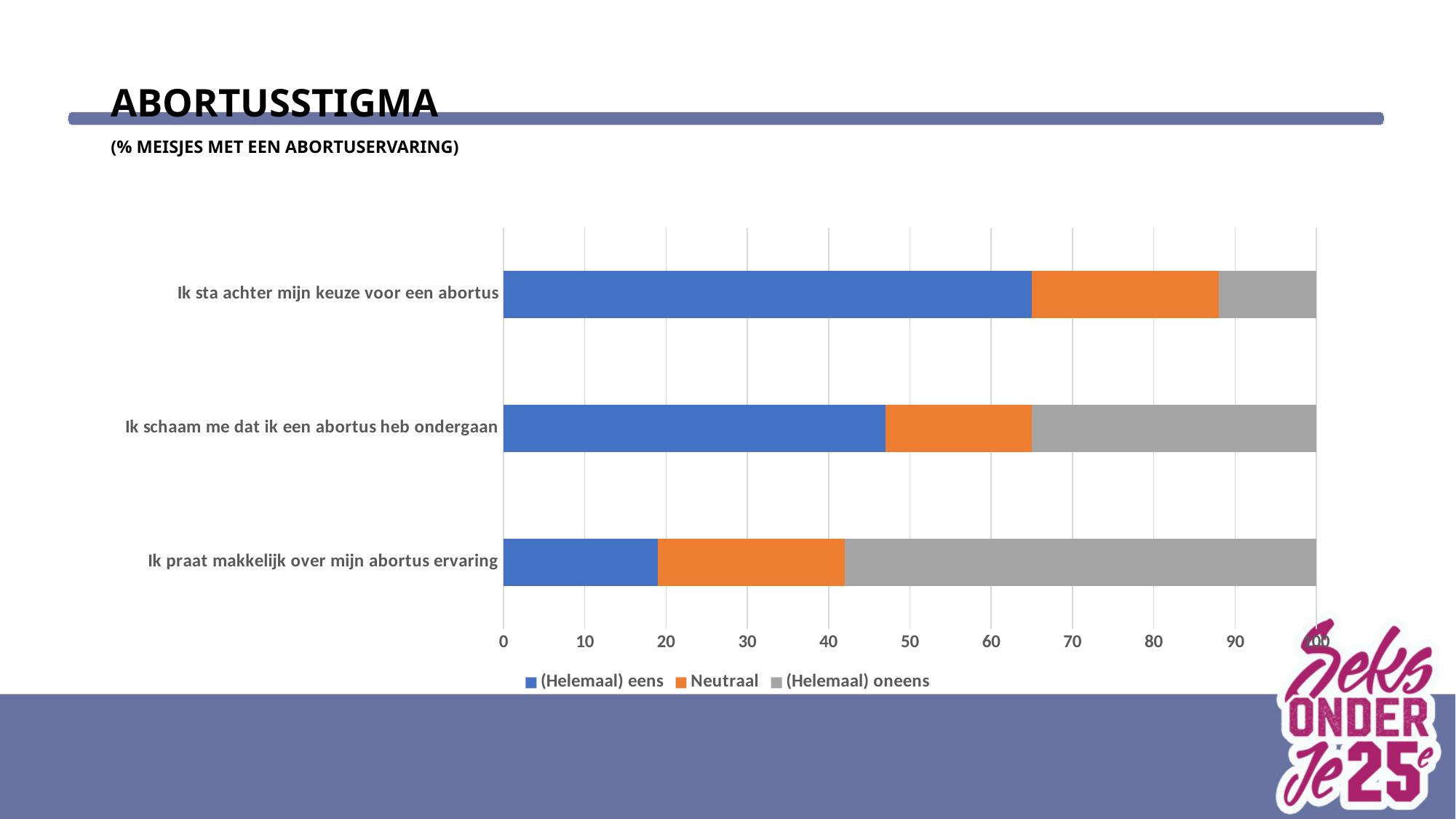
Is the '(Helemaal) eens' value for 'Ik sta achter mijn keuze voor een abortus' greater or less than 60? greater Which statement has the largest '(Helemaal) eens' segment? Ik sta achter mijn keuze voor een abortus Is the '(Helemaal) eens' value for 'Ik praat makkelijk over mijn abortus ervaring' greater or less than 30? less How many statements (categories) are plotted on the chart? 3 What is the title of the slide? ABORTUSSTIGMA Which has a larger '(Helemaal) eens' share: 'Ik sta achter mijn keuze voor een abortus' or 'Ik schaam me dat ik een abortus heb ondergaan'? Ik sta achter mijn keuze voor een abortus How many series does the legend list? 3 What are the three legend entries of the chart? (Helemaal) eens, Neutraal, (Helemaal) oneens Which statement has the smallest '(Helemaal) eens' segment? Ik praat makkelijk over mijn abortus ervaring Which statement has the largest '(Helemaal) oneens' segment? Ik praat makkelijk over mijn abortus ervaring Is the '(Helemaal) eens' value for 'Ik schaam me dat ik een abortus heb ondergaan' greater or less than 40? greater What kind of chart is shown on the slide? Stacked bar chart